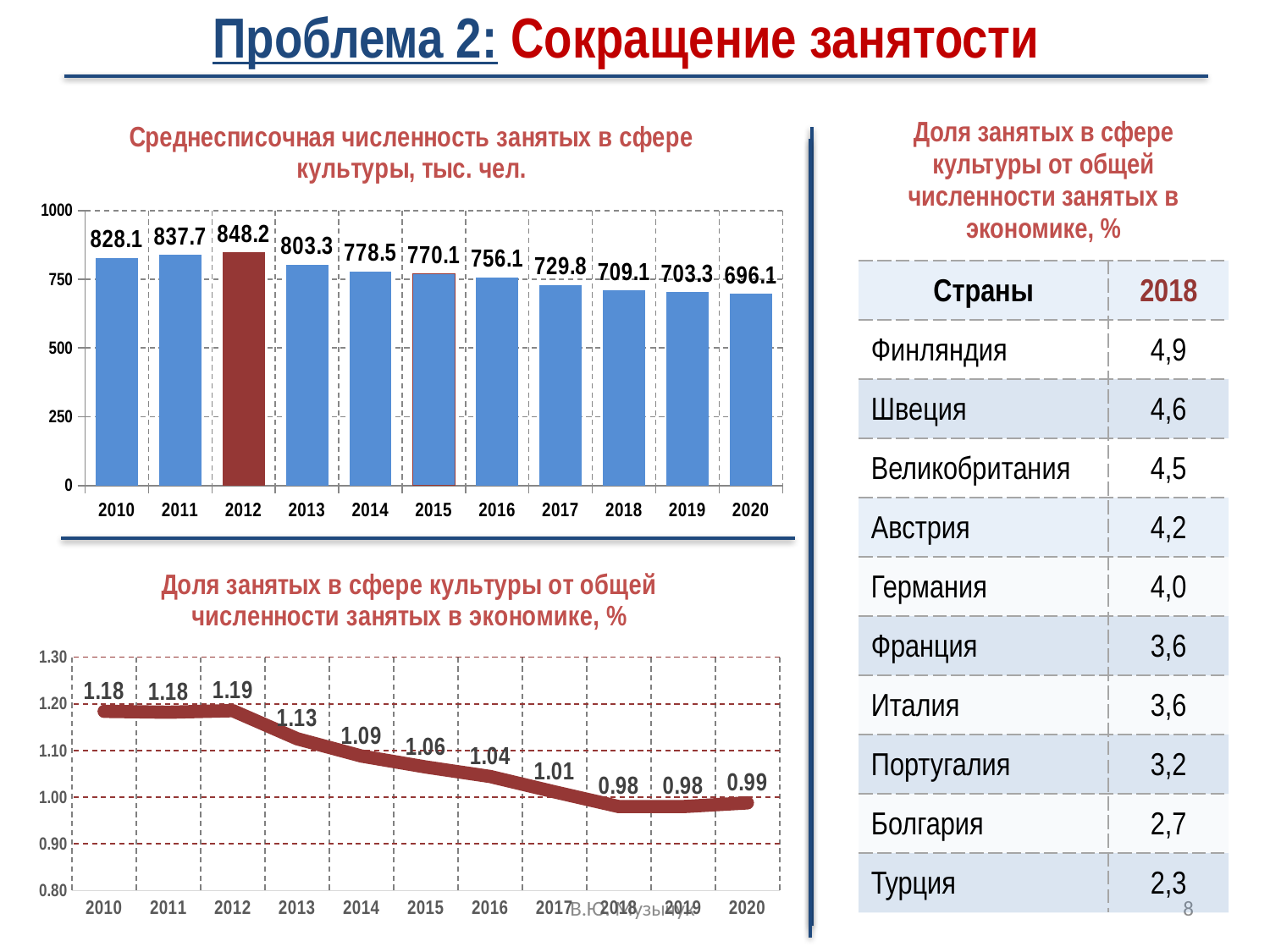
In the bottom line chart, which year has the highest value? 2012 What kind of chart is the top chart on the slide? Bar chart In the top bar chart, what is the value for 2020? 696.1 In the top bar chart, which bar is coloured differently (dark red) from the others? 2012 In the top bar chart, which year has the highest value? 2012 In the top bar chart, which is larger: the value for 2013 or the value for 2017? 2013 In the top bar chart, what is the difference between the values for 2012 and 2020? 152.1 How many years are shown in the top bar chart? 11 In the top bar chart, which year has the lowest value? 2020 In the top bar chart 'Среднесписочная численность занятых в сфере культуры, тыс. чел.', what is the value for 2012? 848.2 In the bottom line chart 'Доля занятых в сфере культуры от общей численности занятых в экономике, %', what is the value for 2016? 1.04 In the bottom line chart, do the values generally rise or fall from 2012 to 2018? Fall